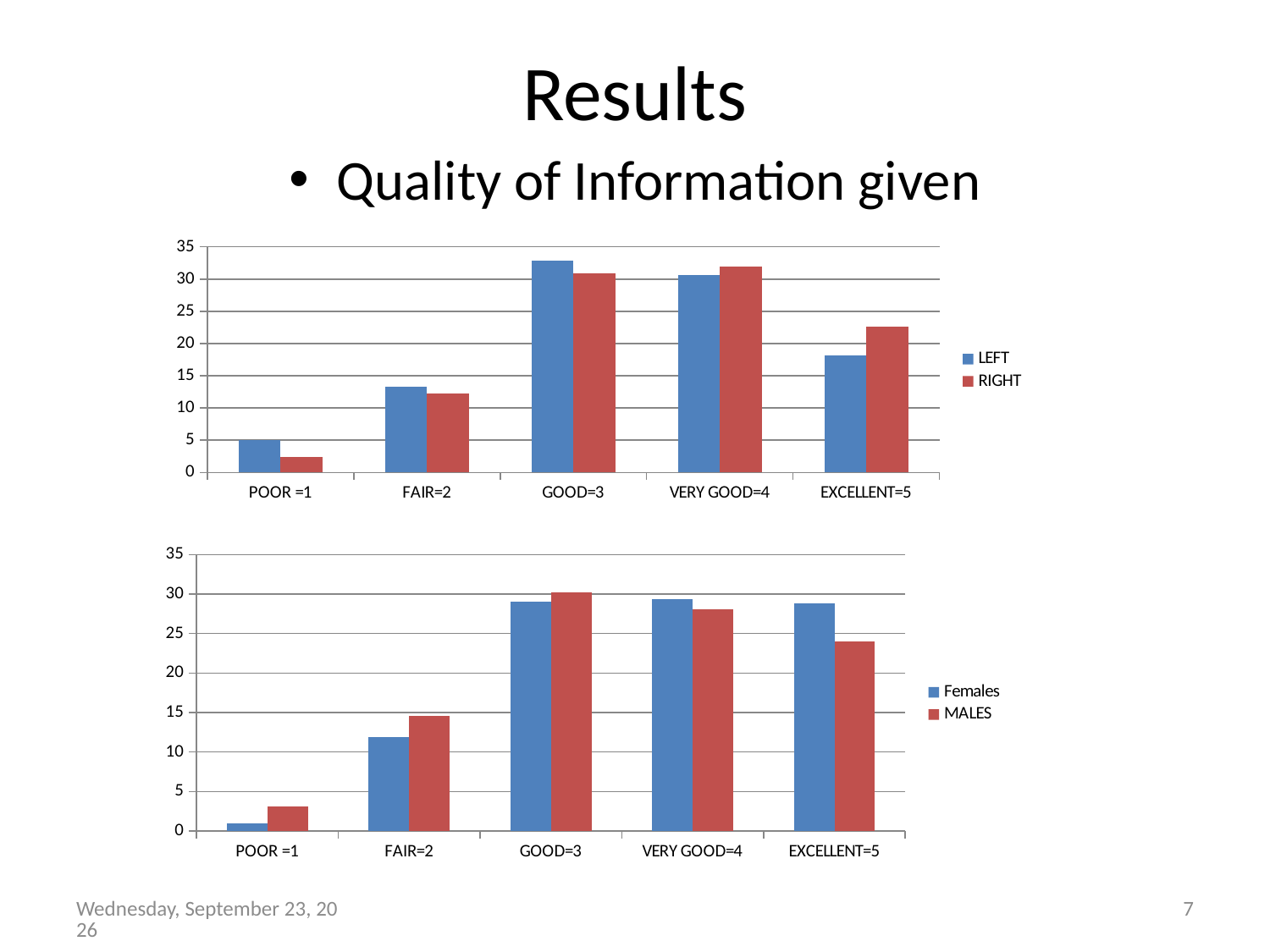
In the bottom chart, is the MALES value for FAIR=2 greater or less than 10? greater In the bottom chart, is the Females value for POOR =1 greater or less than 5? less In the top chart, which is larger for EXCELLENT=5, LEFT or RIGHT? RIGHT In the top chart, is the RIGHT value for EXCELLENT=5 greater or less than 20? greater In the top chart, which category has the highest LEFT value? GOOD=3 In the bottom chart, which is larger for EXCELLENT=5, Females or MALES? Females What are the two legend entries of the bottom chart? Females and MALES How many categories are shown on the x axis of the top chart? 5 In the bottom chart, which category has the lowest Females value? POOR =1 In the top chart, which category has the lowest RIGHT value? POOR =1 How many series does the legend of the top chart list? 2 What kind of chart is the top chart on the slide? bar chart